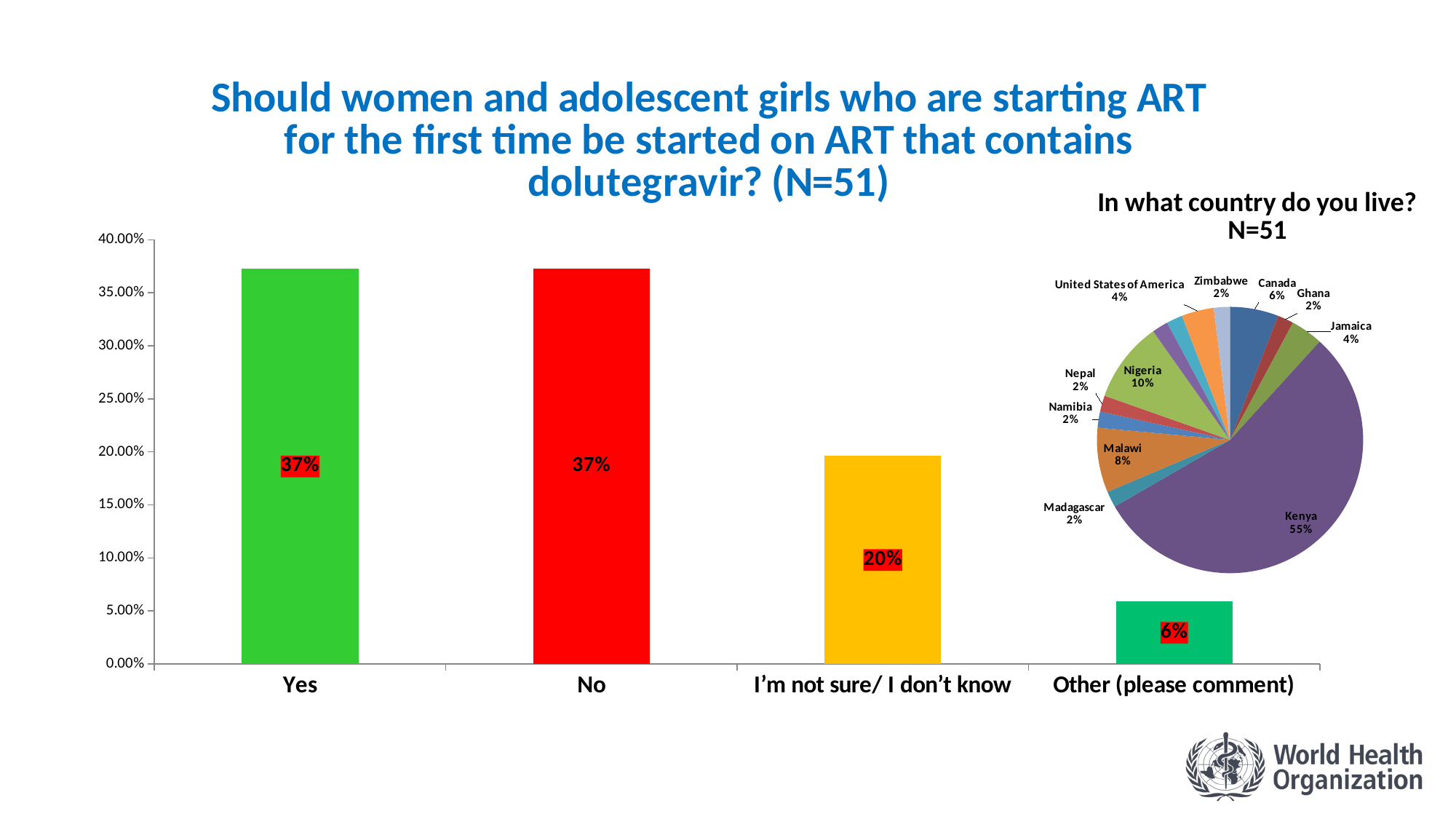
In the bar chart, what percentage of respondents answered "No"? 37% In the bar chart, which response category has the lowest value? Other (please comment) In the pie chart "In what country do you live?", which country has the largest share? Kenya In the bar chart, what is the value for "I'm not sure/ I don't know"? 20% In the pie chart "In what country do you live?", what is the share for Nigeria? 10% How many countries are shown as slices in the pie chart "In what country do you live?"? 13 In the bar chart, which is larger: the value for "No" or the value for "I'm not sure/ I don't know"? No In the pie chart "In what country do you live?", which is larger: the share for Malawi or the share for Canada? Malawi What type of chart is the chart on the left of the slide? Bar chart How many response categories are shown in the bar chart? 4 In the pie chart "In what country do you live?", what share of respondents live in Kenya? 55% In the bar chart, what is the difference between the "Yes" value and the "I'm not sure/ I don't know" value? 17%